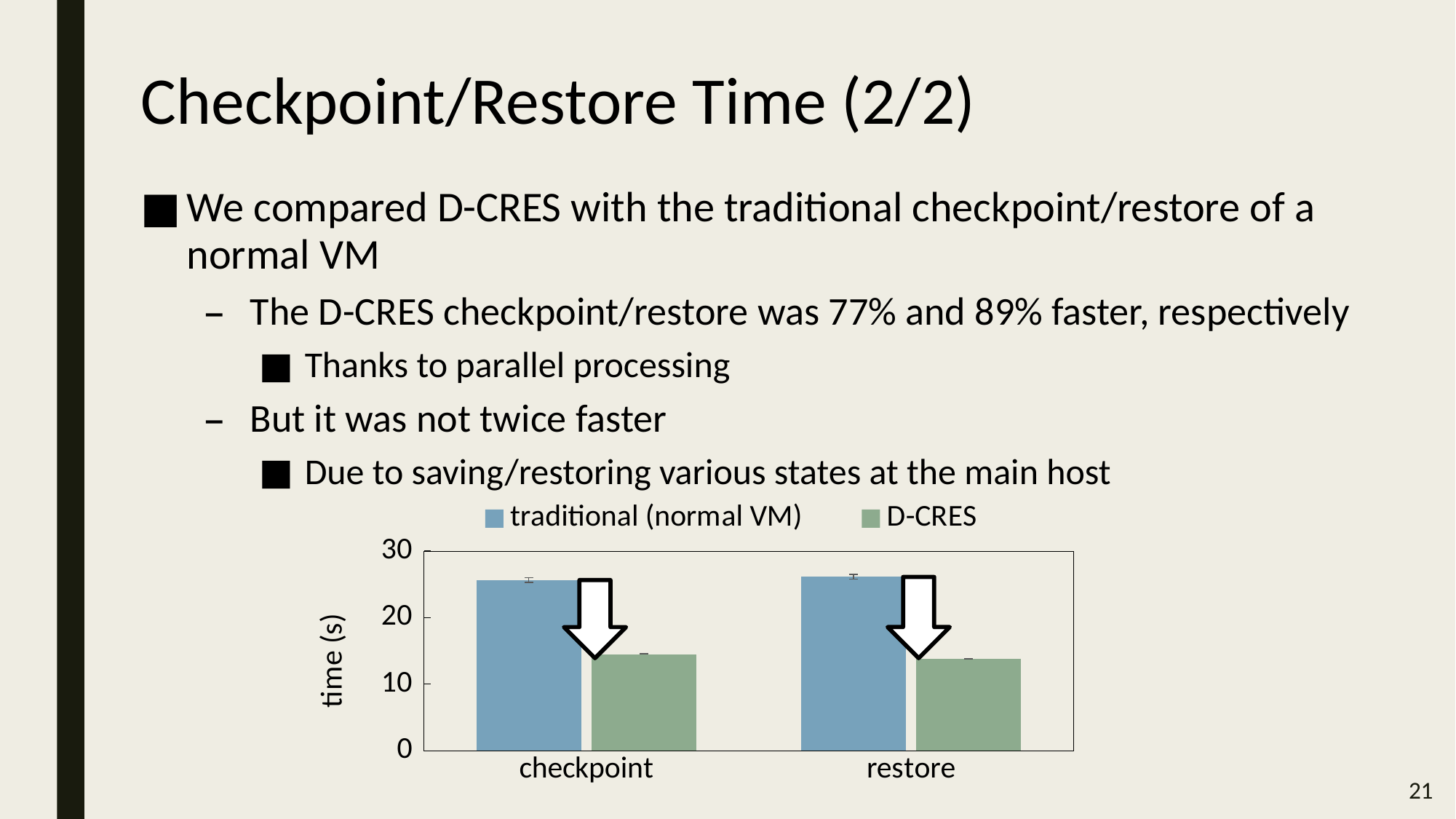
Which series is shown in green in the chart? D-CRES What kind of chart is shown on the slide? bar chart For the restore category, which is smaller: traditional (normal VM) or D-CRES? D-CRES Is the value for D-CRES in the restore category greater or less than 10? greater What is the highest value shown on the y axis of the chart? 30 What is the label of the y axis of the chart? time (s) How many categories are shown on the x axis of the chart? 2 For the checkpoint category, which is larger: traditional (normal VM) or D-CRES? traditional (normal VM) Is the value for D-CRES in the checkpoint category greater or less than 20? less Is the value for traditional (normal VM) in the restore category greater or less than 30? less How many series does the chart's legend list? 2